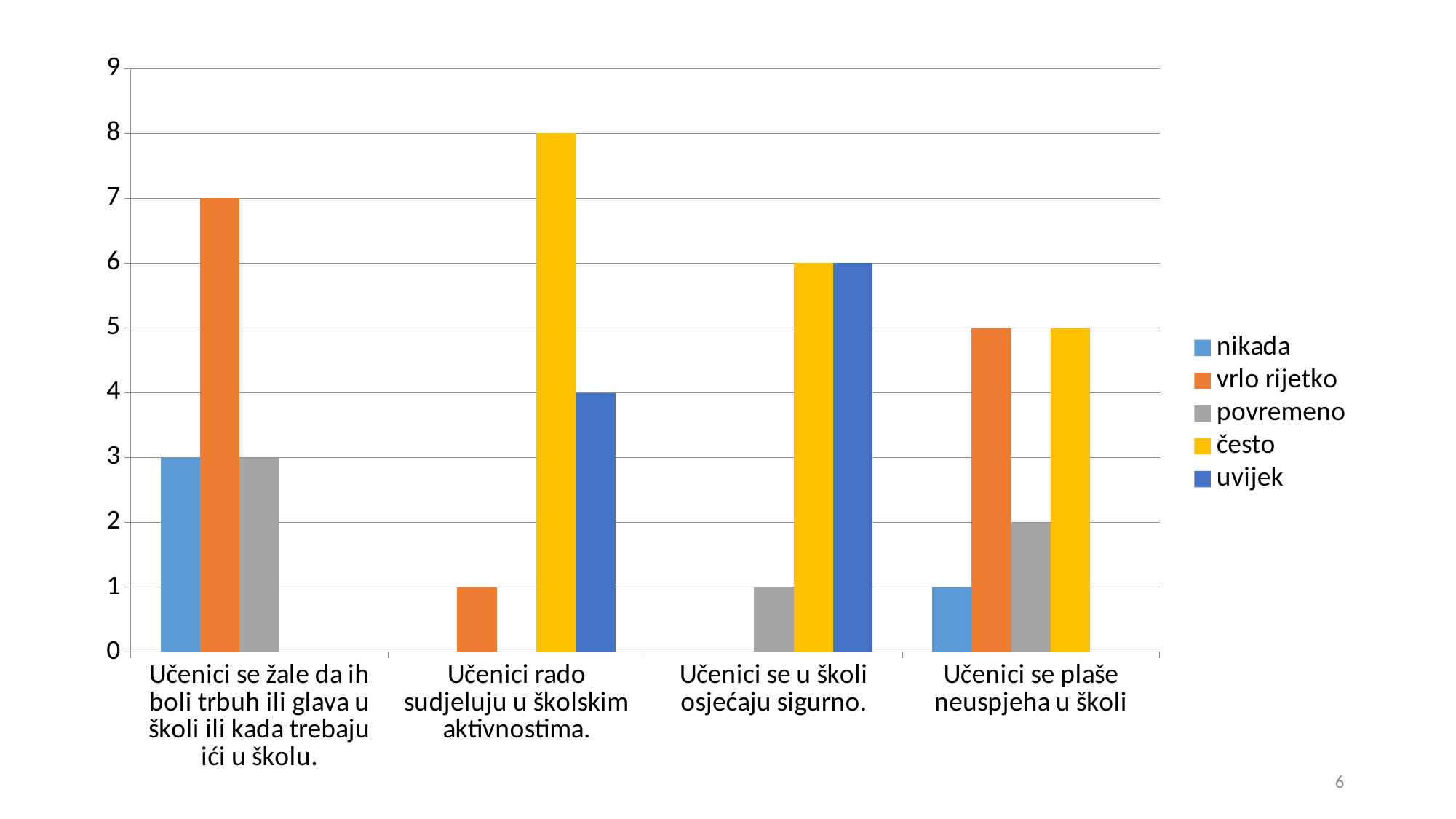
Which series has the highest value for 'Učenici rado sudjeluju u školskim aktivnostima.'? često Which series has the lowest value for 'Učenici se plaše neuspjeha u školi'? nikada How many series does the legend list? 5 What is the value of 'uvijek' for 'Učenici se u školi osjećaju sigurno.'? 6 What is the value of 'često' for 'Učenici rado sudjeluju u školskim aktivnostima.'? 8 Which is larger for 'Učenici se žale da ih boli trbuh ili glava u školi ili kada trebaju ići u školu.': 'nikada' or 'vrlo rijetko'? vrlo rijetko What is the value of 'vrlo rijetko' for 'Učenici se žale da ih boli trbuh ili glava u školi ili kada trebaju ići u školu.'? 7 Which legend entry is shown in yellow? često What kind of chart is shown on the slide? bar chart How many categories are shown on the x axis? 4 What is the value of 'povremeno' for 'Učenici se plaše neuspjeha u školi'? 2 What is the difference between 'često' and 'uvijek' for 'Učenici rado sudjeluju u školskim aktivnostima.'? 4